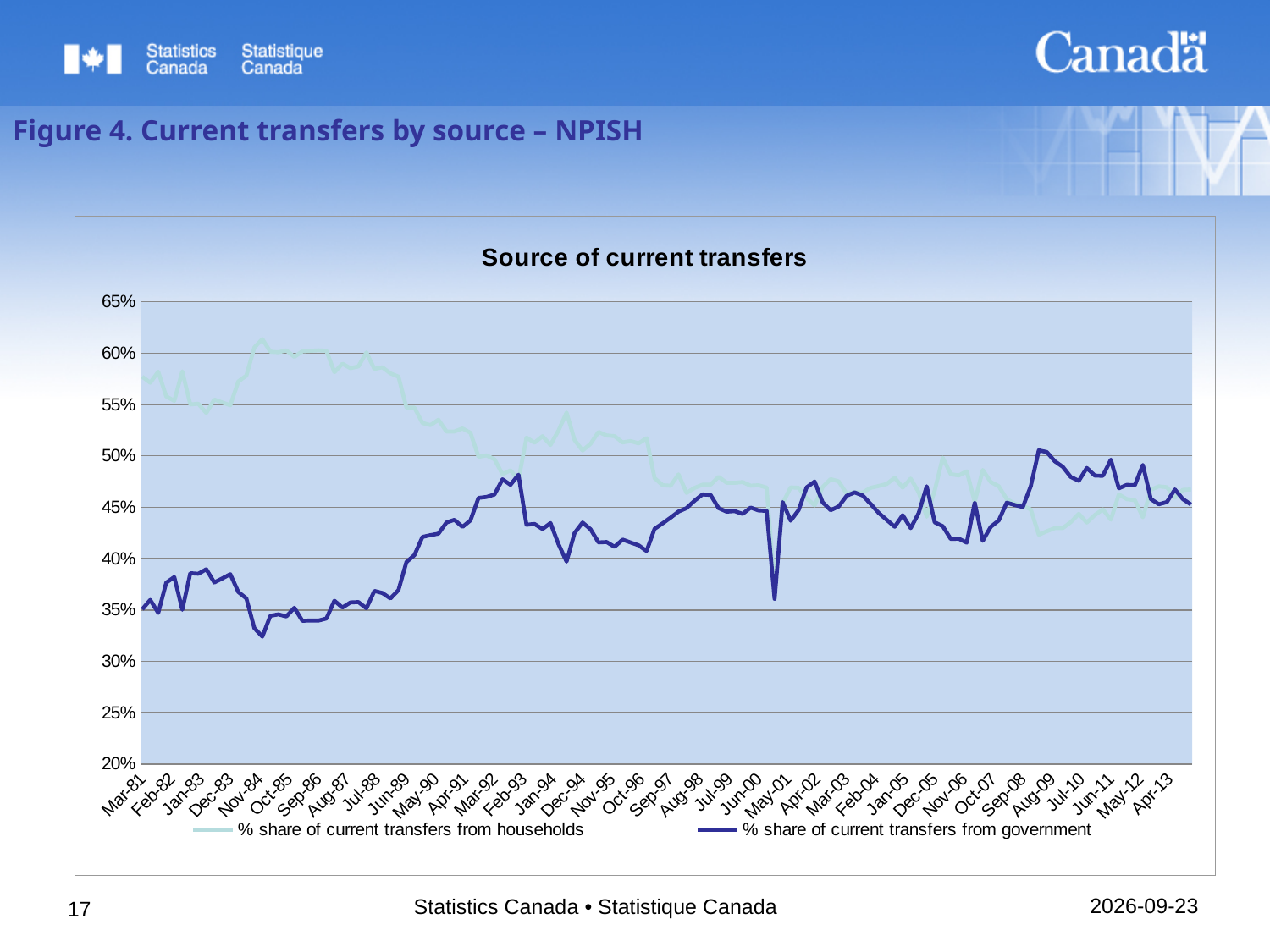
Which series has the higher value at Mar-81, households or government? % share of current transfers from households Is the value for % share of current transfers from households at Mar-81 greater or less than 55%? greater Is the value for % share of current transfers from government at Aug-09 greater or less than 45%? greater Does the % share of current transfers from households generally rise or fall from Mar-81 to Apr-13? fall Is the value for % share of current transfers from government at Mar-81 greater or less than 40%? less How many series does the legend list? 2 What is the title of the chart? Source of current transfers Which series has the higher value at Aug-09, households or government? % share of current transfers from government What kind of chart is shown on the slide? line chart Which series is drawn in dark blue? % share of current transfers from government